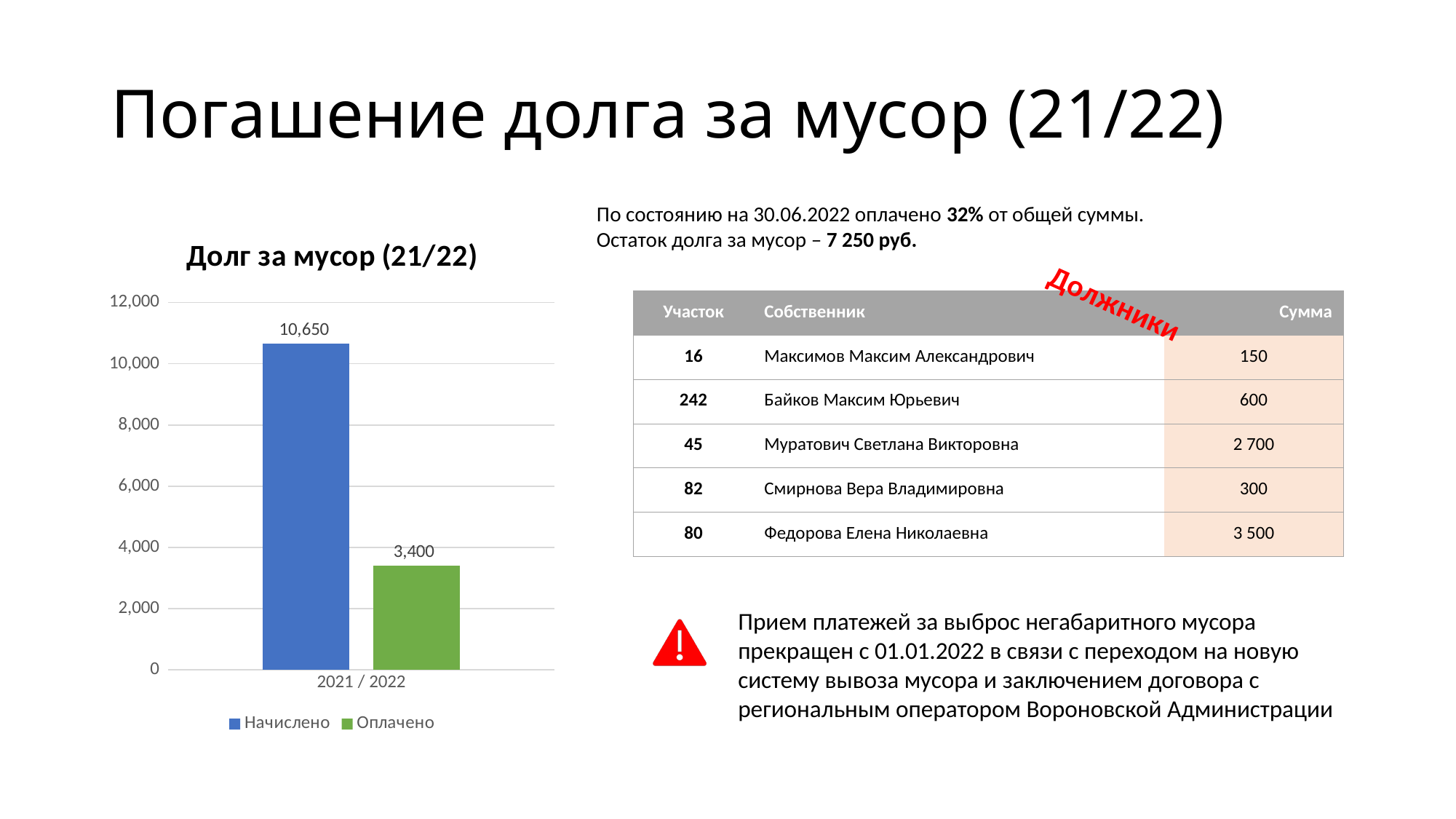
How many categories are shown on the x axis of the chart? 1 Is the value for Оплачено greater or less than 4,000? less What is the value of Начислено in the chart? 10,650 How many series does the chart legend list? 2 What is the value of Оплачено in the chart? 3,400 Which series has the lowest value in the chart? Оплачено Is the value for Начислено greater or less than 10,000? greater What is the title of the chart? Долг за мусор (21/22) What is the category label on the x axis of the chart? 2021 / 2022 What type of chart is shown on the slide? Bar chart What is the difference between Начислено and Оплачено? 7,250 Which series has the higher value, Начислено or Оплачено? Начислено